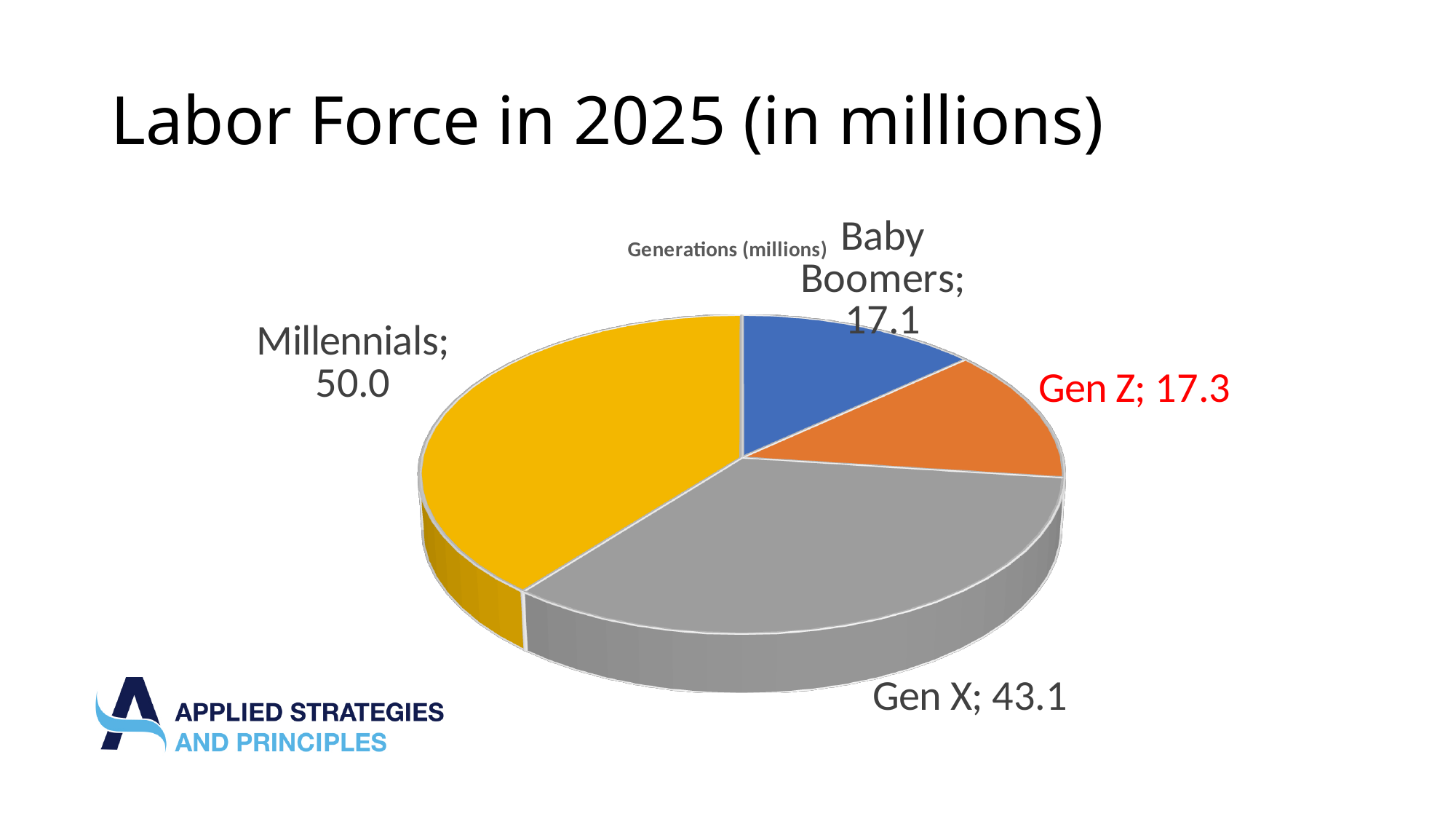
What is the value for Gen X? 43.1 What type of chart is shown on the slide? Pie chart What is the title printed on the chart itself? Generations (millions) Which generation has the largest slice of the pie? Millennials What is the difference between the Gen Z value and the Baby Boomers value? 0.2 Which generation has the smallest value? Baby Boomers What is the value for Millennials? 50.0 Which is larger, the value for Gen X or the value for Gen Z? Gen X What is the value for Gen Z? 17.3 What is the difference between the Millennials value and the Gen X value? 6.9 How many slices does the pie chart have? 4 What is the value for Baby Boomers? 17.1